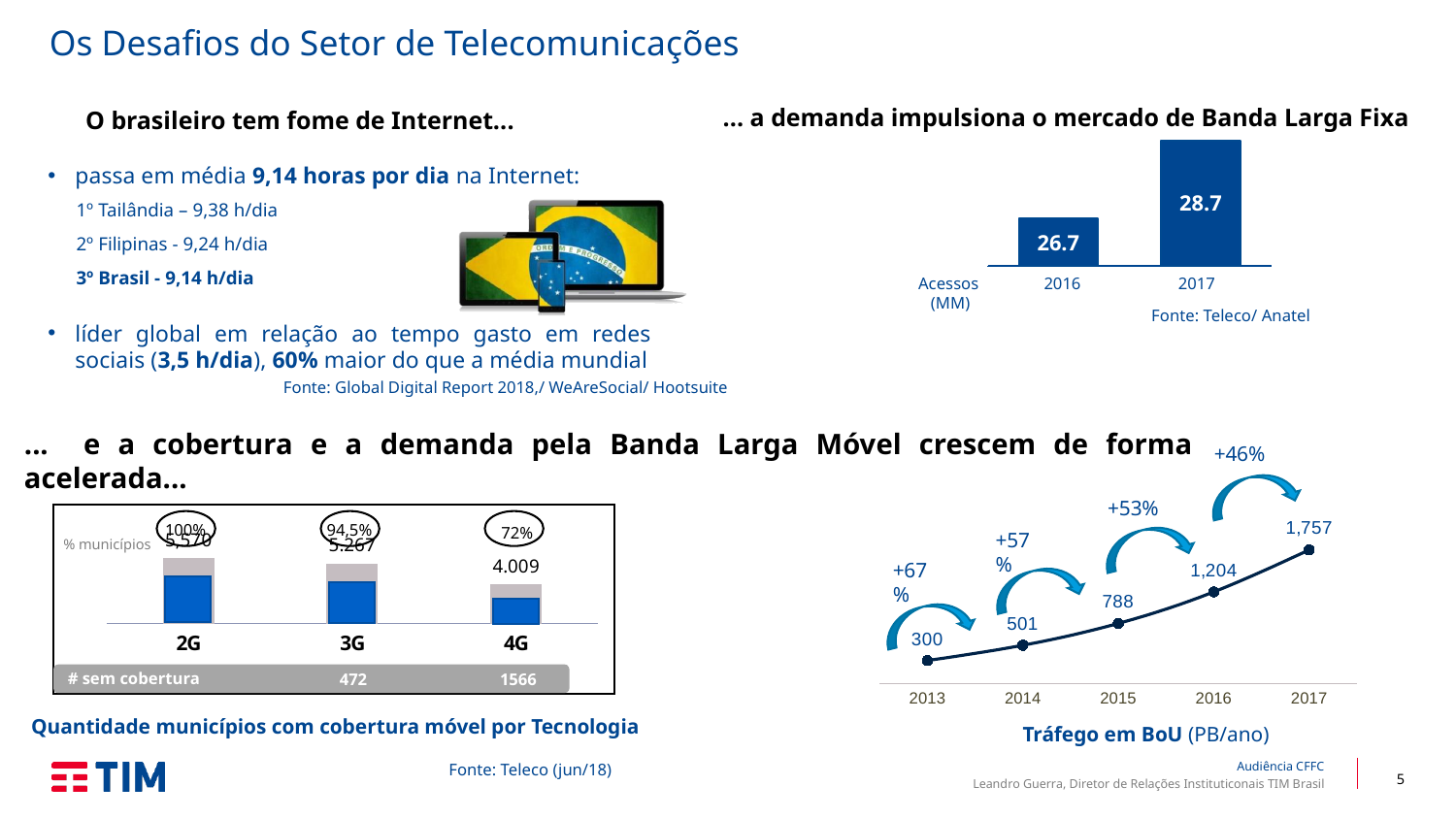
In the Tráfego em BoU (PB/ano) chart, what is the value for 2013? 300 In the Quantidade municípios com cobertura móvel por Tecnologia chart, what percentage of municipalities has 3G coverage? 94,5% In the Tráfego em BoU (PB/ano) chart, what is the value for 2017? 1,757 In the Acessos (MM) chart, what is the difference between the 2017 and 2016 values? 2.0 In the Quantidade municípios com cobertura móvel por Tecnologia chart, what is the number of municipalities with 4G coverage? 4.009 In the Acessos (MM) chart, what is the value for 2016? 26.7 In the Tráfego em BoU (PB/ano) chart, what is the percentage growth shown between 2016 and 2017? +46% In the Tráfego em BoU (PB/ano) chart, what is the value for 2015? 788 In the Tráfego em BoU (PB/ano) chart, do the values rise or fall from 2013 to 2017? rise What kind of chart is the Acessos (MM) chart? bar chart In the Tráfego em BoU (PB/ano) chart, how many years are plotted? 5 In the Acessos (MM) chart, what is the value for 2017? 28.7